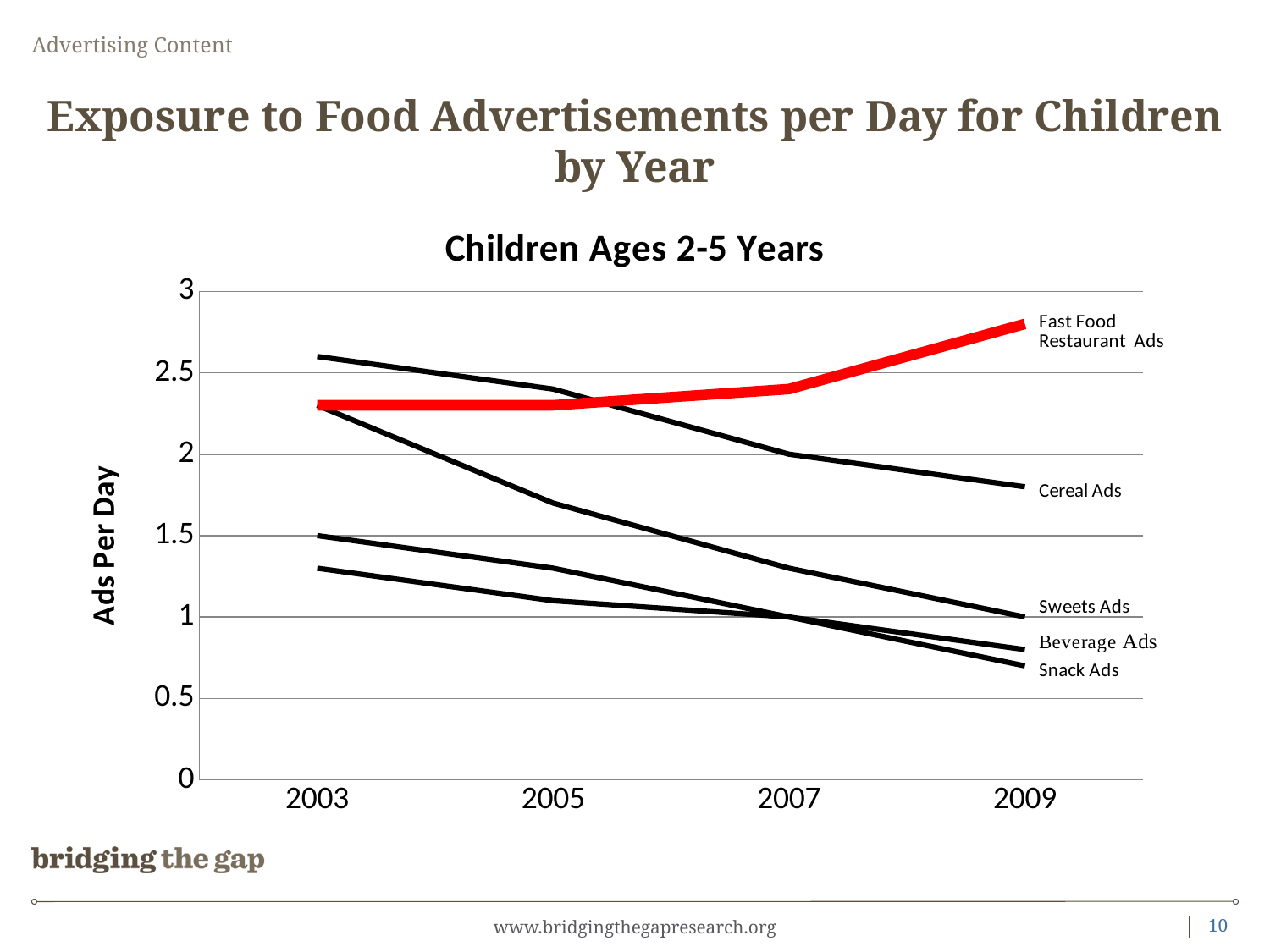
What type of chart is shown on the slide? Line chart Which series has the highest value in 2003? Cereal Ads What is the value for Beverage Ads in 2003? 1.5 Is the value for Fast Food Restaurant Ads in 2009 greater or less than 2.5? greater Which series has the lowest value in 2009? Snack Ads What is the value for Cereal Ads in 2007? 2 Is the value for Snack Ads in 2009 greater or less than 1? less Do the values for Fast Food Restaurant Ads rise or fall from 2003 to 2009? Rise How many years are shown on the x axis of the chart? 4 How many series are plotted in the chart? 5 Which series has the highest value in 2009? Fast Food Restaurant Ads Which series is drawn in red? Fast Food Restaurant Ads